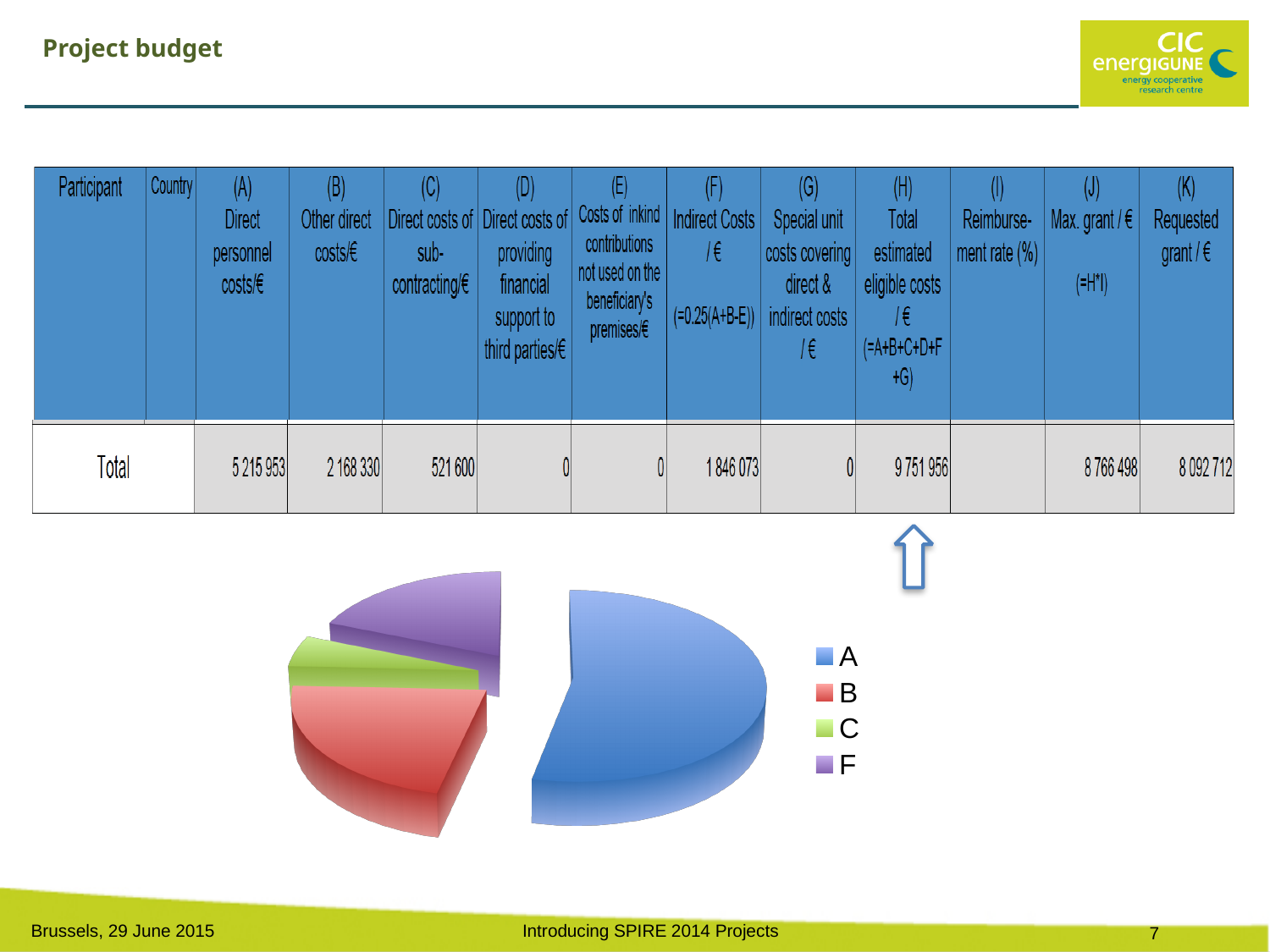
Which category has the smallest slice in the pie chart? C What are the legend entries of the pie chart, in order? A, B, C, F In the pie chart, which slice is larger, B or C? B In the pie chart, which slice is larger, C or F? F In the pie chart, which slice is larger, A or B? A What kind of chart is shown on the slide? pie chart How many entries does the pie chart's legend list? 4 How many slices does the pie chart have? 4 What colour is slice A in the pie chart? blue Which category has the largest slice in the pie chart? A